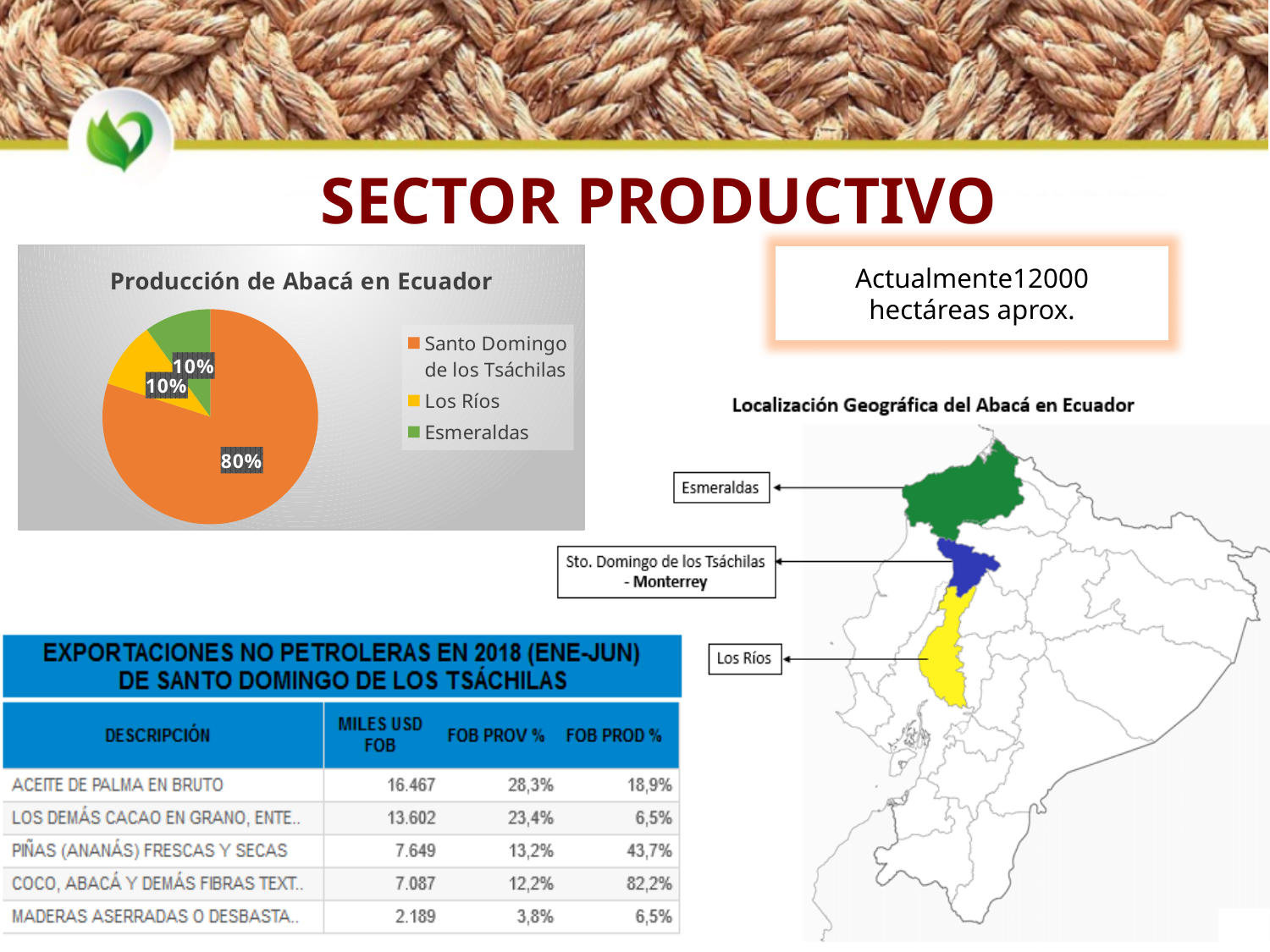
In the pie chart "Producción de Abacá en Ecuador", what is the difference in percentage points between Santo Domingo de los Tsáchilas and Los Ríos? 70 percentage points Which province has the largest slice in the pie chart "Producción de Abacá en Ecuador"? Santo Domingo de los Tsáchilas In the pie chart "Producción de Abacá en Ecuador", what combined share do Los Ríos and Esmeraldas account for? 20% In the pie chart "Producción de Abacá en Ecuador", what percentage is shown for Esmeraldas? 10% In the pie chart "Producción de Abacá en Ecuador", what percentage is shown for Santo Domingo de los Tsáchilas? 80% How many slices does the pie chart "Producción de Abacá en Ecuador" have? 3 In the pie chart "Producción de Abacá en Ecuador", what percentage is shown for Los Ríos? 10% In the pie chart "Producción de Abacá en Ecuador", what colour is the slice for Santo Domingo de los Tsáchilas? Orange What kind of chart is "Producción de Abacá en Ecuador"? Pie chart What is the title of the pie chart on the slide? Producción de Abacá en Ecuador How many entries does the legend of the pie chart "Producción de Abacá en Ecuador" list? 3 In the pie chart "Producción de Abacá en Ecuador", which is larger, the slice for Santo Domingo de los Tsáchilas or the slice for Esmeraldas? Santo Domingo de los Tsáchilas